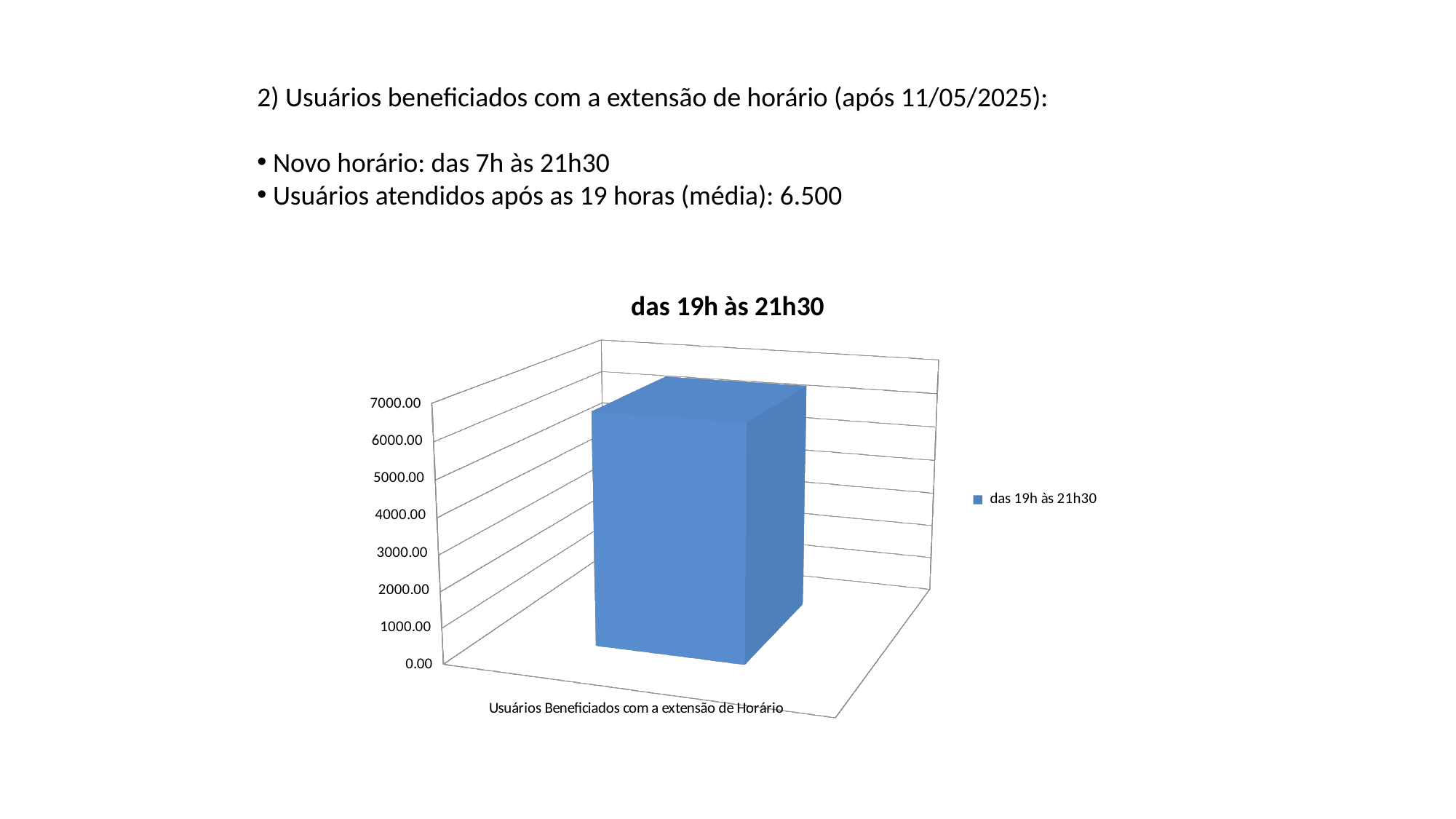
Is the value for Usuários Beneficiados com a extensão de Horário greater or less than 5000.00? greater Is the value for Usuários Beneficiados com a extensão de Horário greater or less than 3000.00? greater How many series does the chart legend list? 1 What is the category label shown on the x axis of the chart? Usuários Beneficiados com a extensão de Horário What kind of chart is shown on the slide? bar chart What is the title of the chart? das 19h às 21h30 How many bars does the chart show? 1 Is the value for Usuários Beneficiados com a extensão de Horário greater or less than 7000.00? less